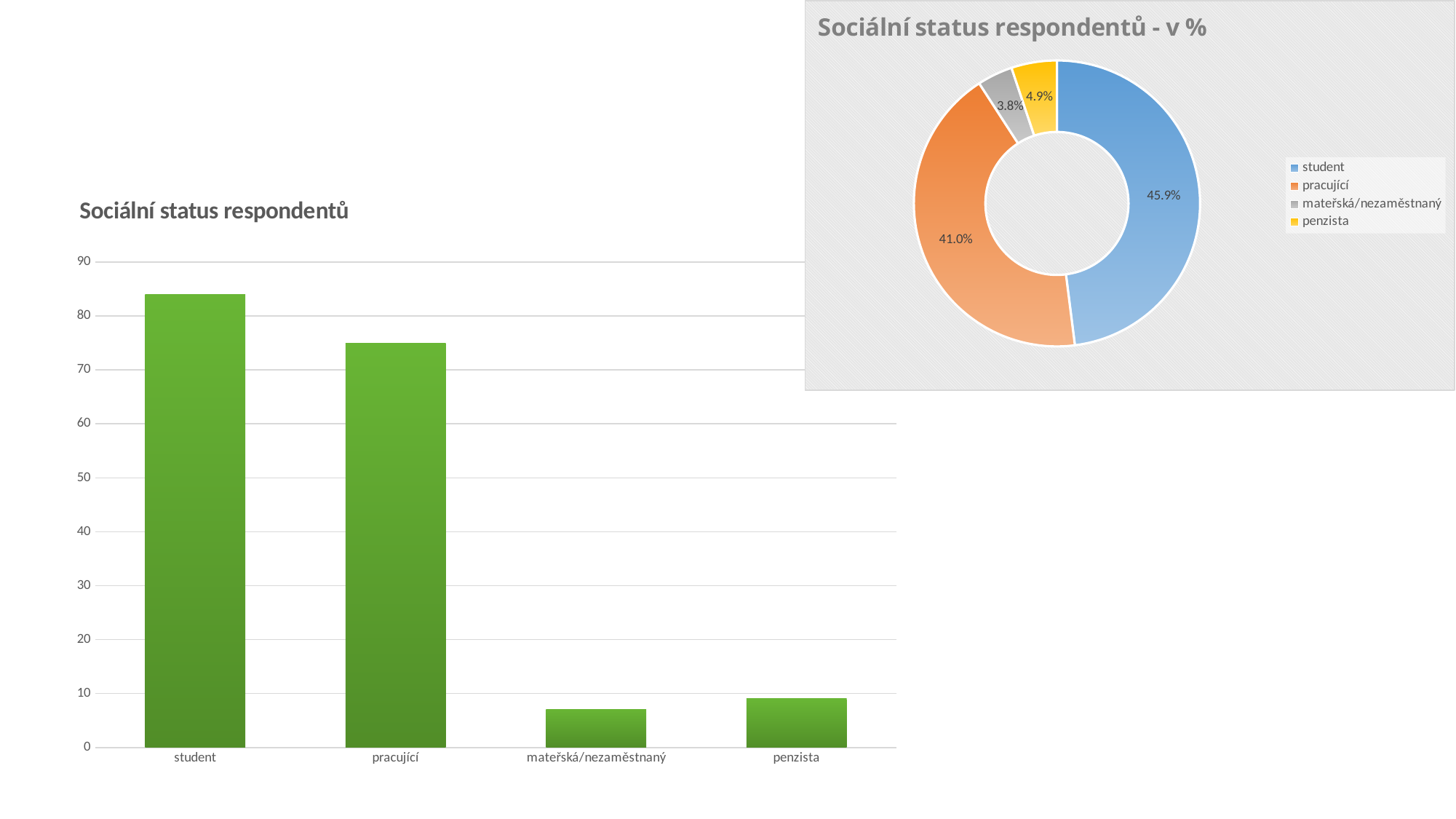
In the bar chart titled 'Sociální status respondentů', is the value for pracující greater or less than 70? greater In the bar chart titled 'Sociální status respondentů', which category has the highest bar? student In the chart titled 'Sociální status respondentů - v %', what share is shown for pracující? 41.0% In the chart titled 'Sociální status respondentů - v %', what is the difference in percentage points between student and pracující? 4.9 In the chart titled 'Sociální status respondentů - v %', what share is shown for mateřská/nezaměstnaný? 3.8% In the chart titled 'Sociální status respondentů - v %', what share is shown for penzista? 4.9% In the chart titled 'Sociální status respondentů - v %', what share is shown for student? 45.9% In the bar chart titled 'Sociální status respondentů', how many categories are shown on the x axis? 4 In the chart titled 'Sociální status respondentů - v %', which category has the smallest share? mateřská/nezaměstnaný In the bar chart titled 'Sociální status respondentů', which category has the lowest bar? mateřská/nezaměstnaný In the chart titled 'Sociální status respondentů - v %', how many entries does the legend list? 4 In the bar chart titled 'Sociální status respondentů', is the value for penzista greater or less than 10? less